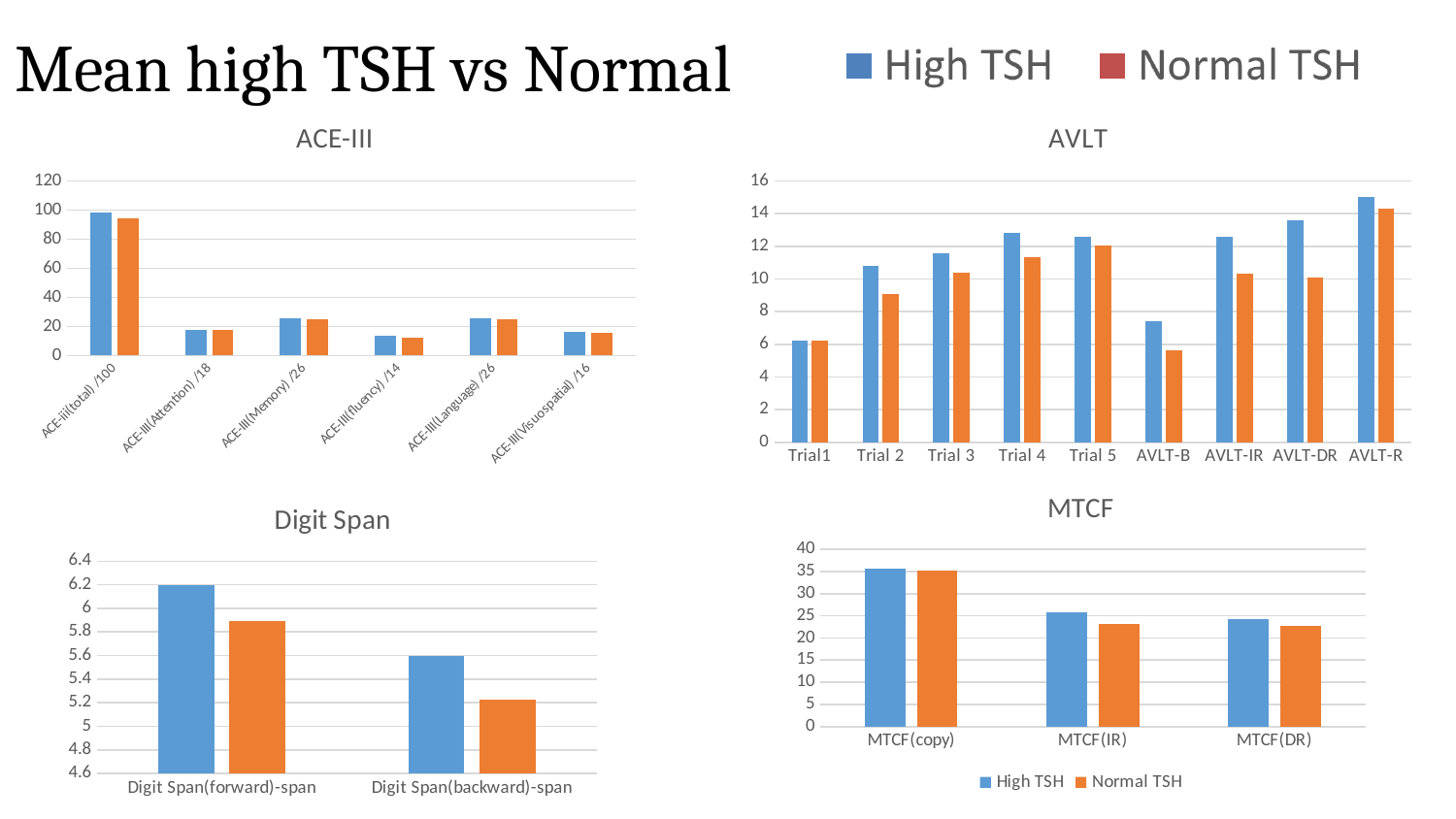
In the AVLT chart, which category has the highest High TSH value? AVLT-R In the AVLT chart, for AVLT-B, which series has the larger value, High TSH or Normal TSH? High TSH What kind of chart is the AVLT chart? bar chart How many charts are shown on the slide? 4 In the AVLT chart, is the Normal TSH value for Trial 2 greater or less than 10? less In the Digit Span chart, is the Normal TSH value for Digit Span(backward)-span greater or less than 5.4? less In the Digit Span chart, how many categories are shown? 2 In the AVLT chart, how many categories are shown on the x axis? 9 In the MTCF chart, which category has the highest values? MTCF(copy) In the ACE-III chart, which category has the highest values? ACE-iii(total) /100 In the ACE-III chart, is the High TSH value for ACE-iii(total) /100 greater or less than 80? greater